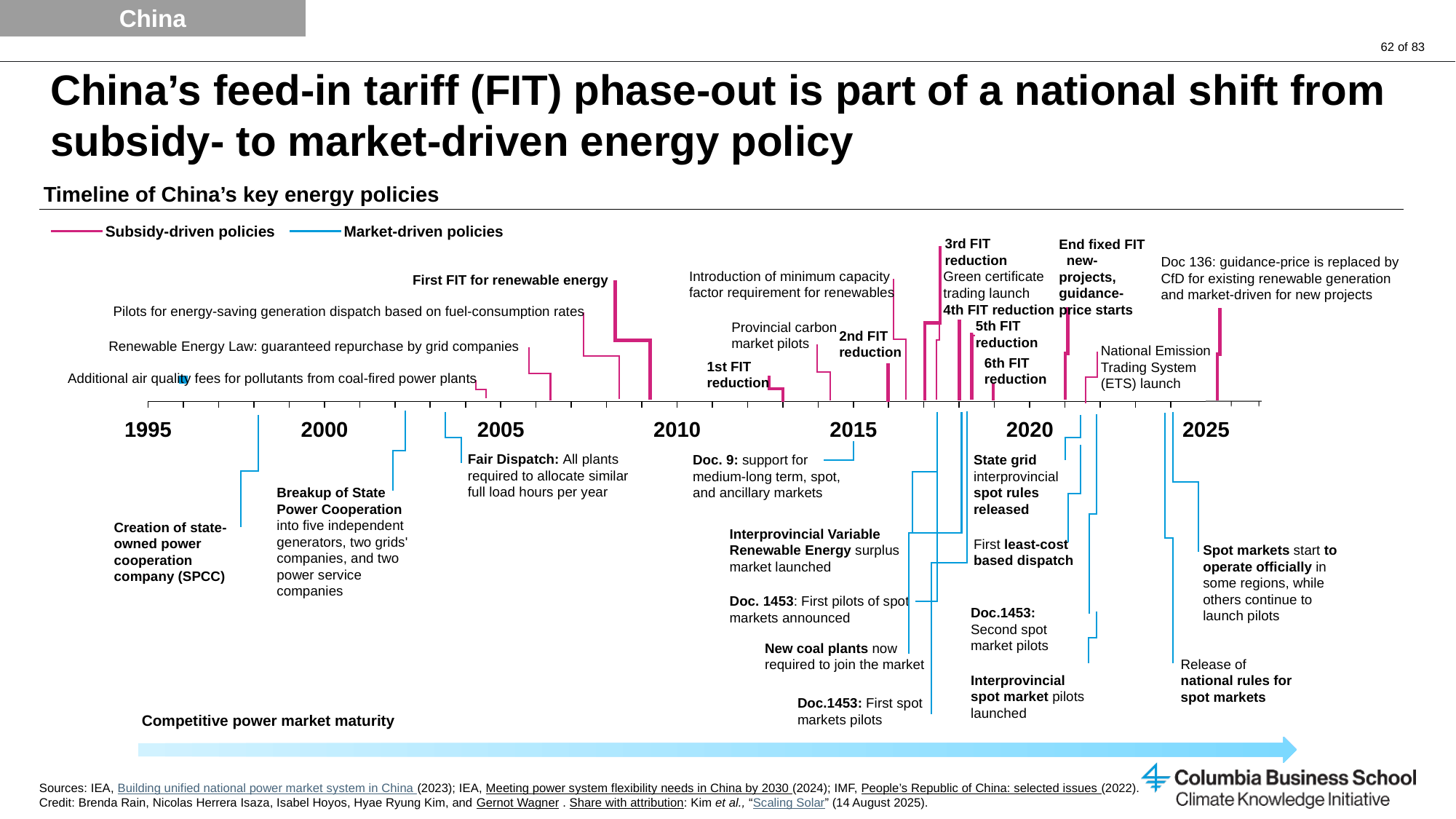
Is the 'Fair Dispatch' event placed before or after 2005 on the timeline? before Which colour represents market-driven policies in the timeline legend? Blue Is the 'Creation of state-owned power cooperation company (SPCC)' event placed before or after 2000 on the timeline? before Is the 'National Emission Trading System (ETS) launch' event placed before or after 2020 on the timeline? after What kind of chart is shown on the slide? Timeline How many numbered FIT reductions (1st, 2nd, etc.) are labeled on the timeline? 6 How many series does the legend of the timeline list? 2 How many year labels are shown along the timeline axis? 7 What is the title of the chart on the slide? Timeline of China's key energy policies What is the earliest year labeled on the timeline axis? 1995 What is the latest year labeled on the timeline axis? 2025